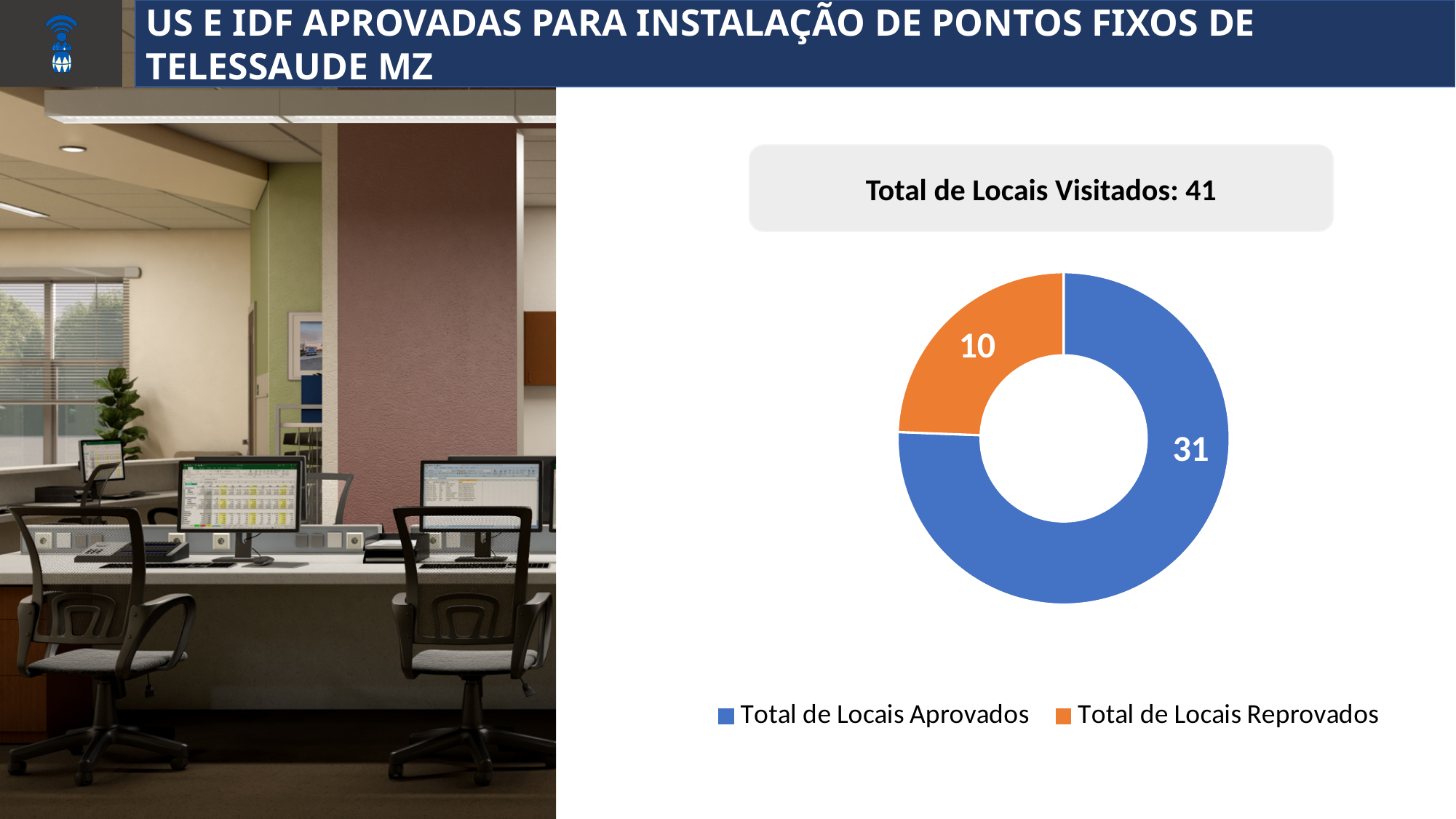
What is the total of the two values shown in the chart? 41 Which category has the lowest value? Total de Locais Reprovados What is the total number of locations visited stated on the slide? 41 Which is larger, Total de Locais Aprovados or Total de Locais Reprovados? Total de Locais Aprovados What is the value for Total de Locais Reprovados? 10 Which category has the highest value? Total de Locais Aprovados How many categories does the chart show? 2 What is the difference between Total de Locais Aprovados and Total de Locais Reprovados? 21 What colour represents Total de Locais Reprovados in the chart? Orange What kind of chart is shown on the slide? Doughnut chart What is the value for Total de Locais Aprovados? 31